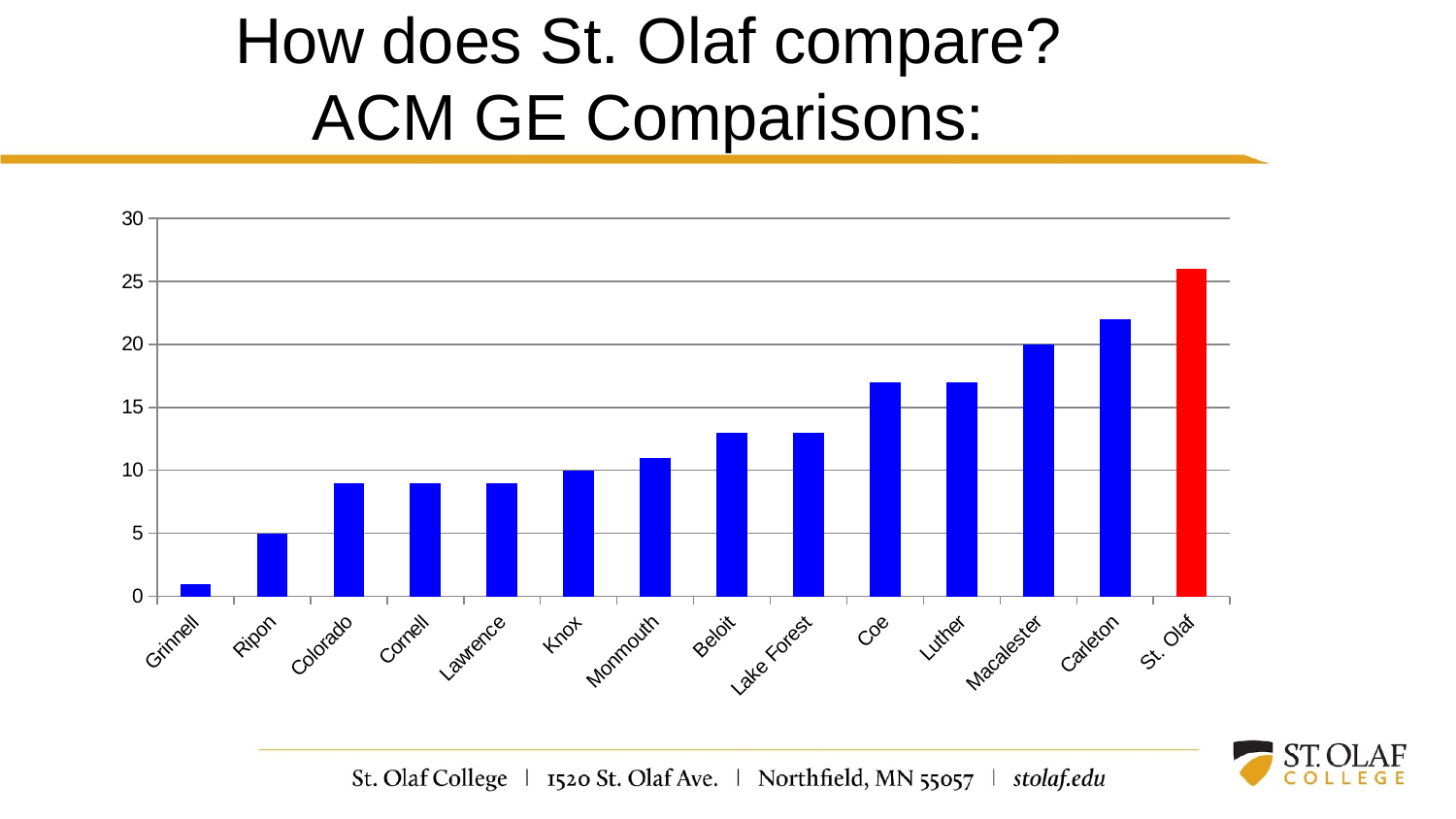
Do the bar values generally rise or fall from left to right along the x axis? rise What is the value for Ripon? 5 What is the value for Knox? 10 Is the value for Carleton greater or less than 25? less Is the value for Grinnell greater or less than 5? less Is the value for St. Olaf greater or less than 25? greater How many colleges are shown on the x axis of the chart? 14 What is the value for Macalester? 20 Which is larger, the value for St. Olaf or the value for Carleton? St. Olaf Which college has the lowest bar in the chart? Grinnell Which college has the highest bar in the chart? St. Olaf What kind of chart is shown on the slide? bar chart